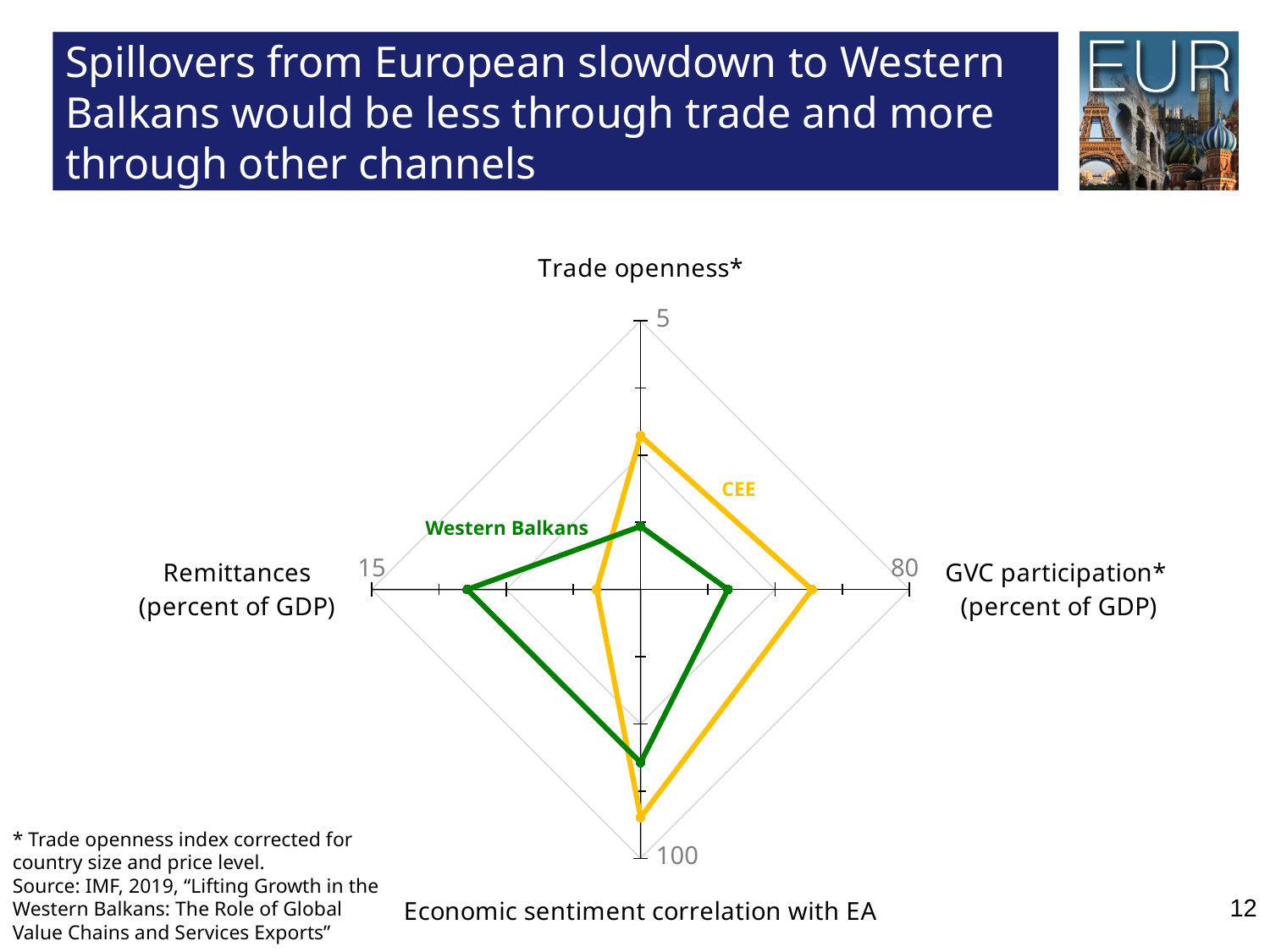
What is the maximum value printed on the Economic sentiment correlation with EA axis? 100 What colour is the line for Western Balkans? Green Which series has the higher value for Economic sentiment correlation with EA, CEE or Western Balkans? CEE What kind of chart is shown on the slide? Radar chart On which axis does Western Balkans exceed CEE? Remittances (percent of GDP) How many axes (categories) does the radar chart have? 4 Which series has the higher value for GVC participation* (percent of GDP), CEE or Western Balkans? CEE Is the value for CEE on the GVC participation* axis greater or less than 80? less Is the value for Western Balkans on the Trade openness* axis greater or less than 5? less How many series does the chart show? 2